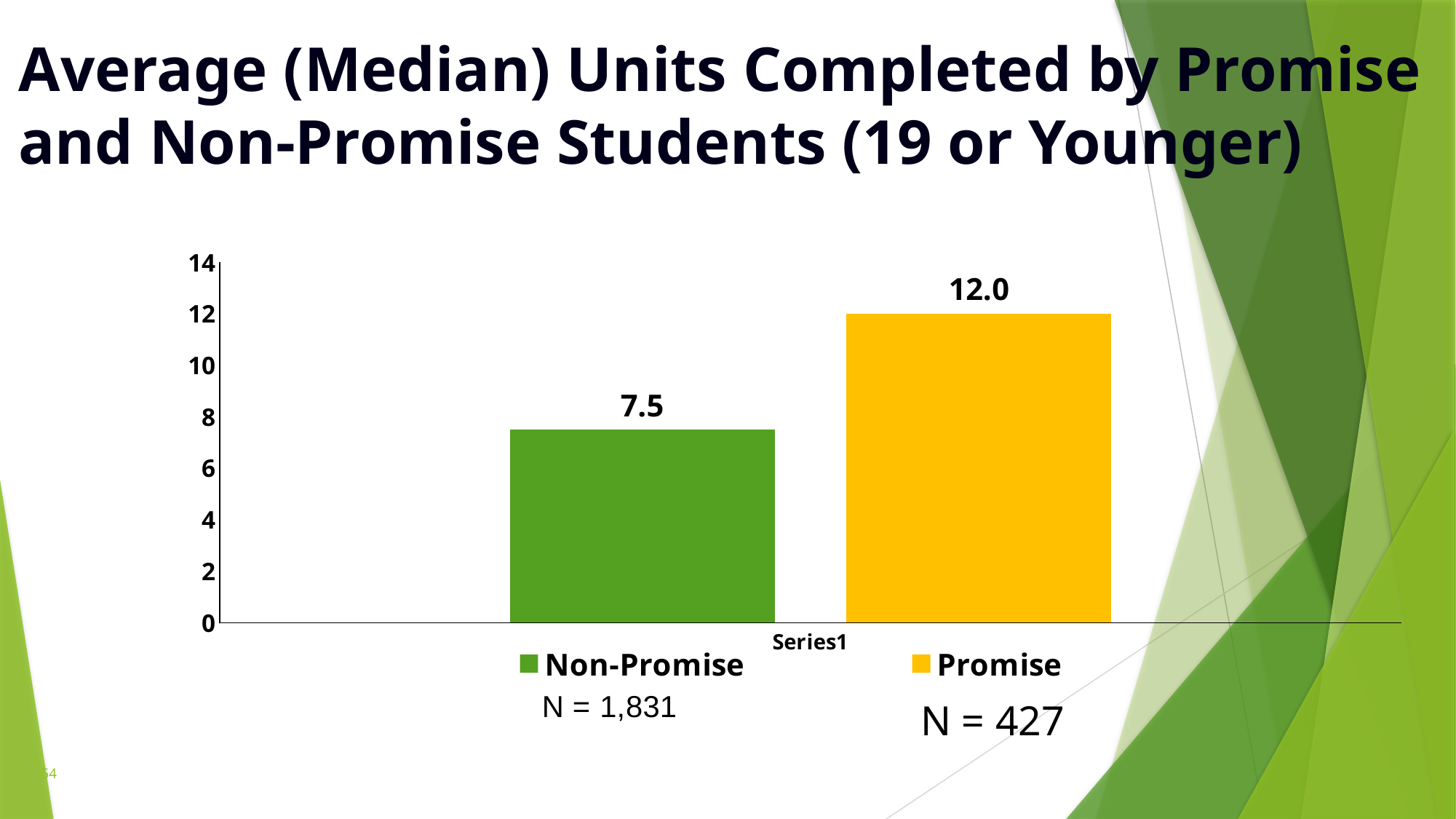
What is the N (sample size) shown for Non-Promise students? N = 1,831 What is the maximum value shown on the vertical axis? 14 What is the median units completed for Non-Promise students? 7.5 What is the difference in median units completed between Promise and Non-Promise students? 4.5 What colour is the bar for Promise students? Yellow What is the median units completed for Promise students? 12.0 What kind of chart is shown on the slide? Bar chart Which group has the higher median units completed? Promise How many series does the legend list? 2 Is the value for Non-Promise students greater or less than 8? less Is the value for Promise students greater or less than 10? greater Which group has the lower median units completed? Non-Promise